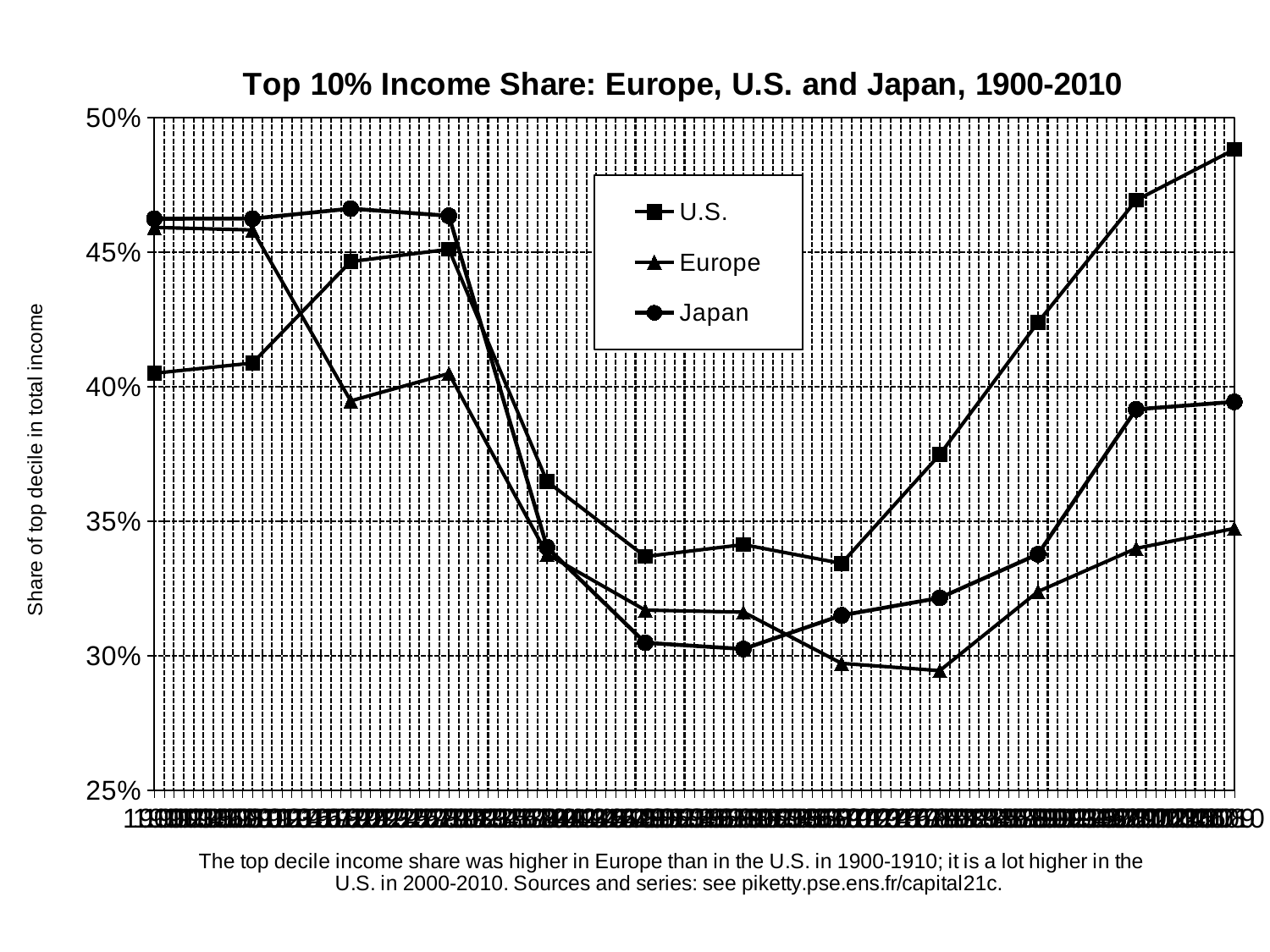
At the leftmost point (1900), which is larger, the Europe value or the U.S. value? Europe At the rightmost point (2010), which is larger, the U.S. value or the Europe value? U.S. Which series falls to the lowest value anywhere on the chart? Europe At the leftmost point (1900), is the value for Japan greater or less than 45%? greater What is the title of the chart? Top 10% Income Share: Europe, U.S. and Japan, 1900-2010 How many data points does the U.S. series have? 12 What kind of chart is shown on the slide? line chart Which series are listed in the legend? U.S., Europe, Japan At the rightmost point (2010), is the value for the U.S. greater or less than 45%? greater At the leftmost point (1900), is the value for the U.S. greater or less than 45%? less How many series does the legend list? 3 Which series reaches the highest value anywhere on the chart? U.S.